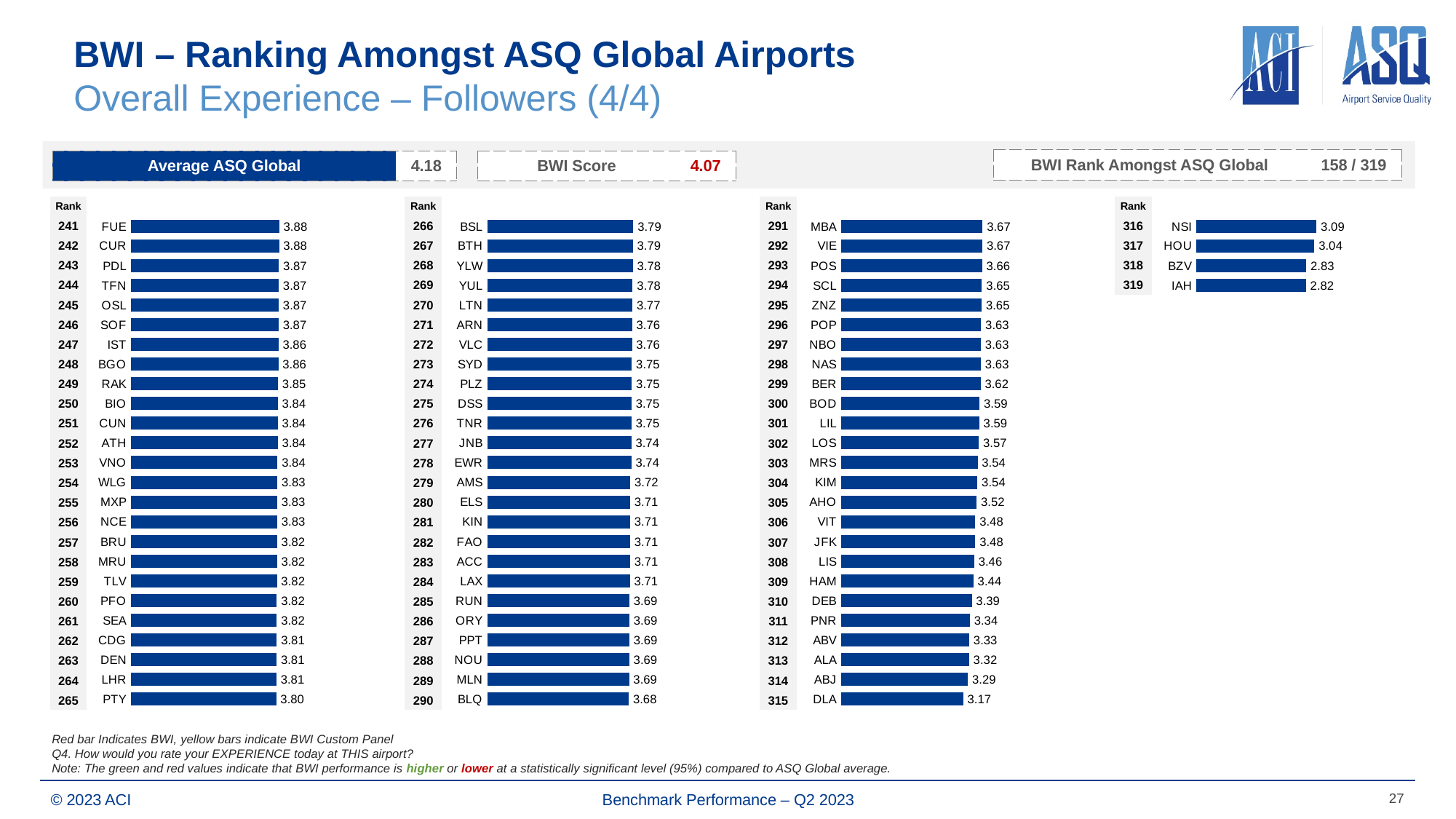
In the rightmost chart (ranks 316–319), what is the score shown for IAH? 2.82 How many airports are listed in the rightmost chart (ranks 316–319)? 4 In the rightmost chart (ranks 316–319), what is the difference between the scores of NSI and IAH? 0.27 What BWI Score is shown in the box at the top of the slide? 4.07 In the third chart from the left (ranks 291–315), which airport has the lowest score? DLA How many airports are listed in the leftmost chart (ranks 241–265)? 25 In the second chart from the left (ranks 266–290), what is the score shown for LAX? 3.71 What kind of chart is used to show the airport scores on this slide? Bar chart In the third chart from the left (ranks 291–315), which has the higher score, JFK or DEB? JFK In the second chart from the left (ranks 266–290), do the scores rise or fall as the rank number increases? Fall In the leftmost chart (ranks 241–265), what is the score shown for FUE? 3.88 In the rightmost chart (ranks 316–319), which airport has the highest score? NSI